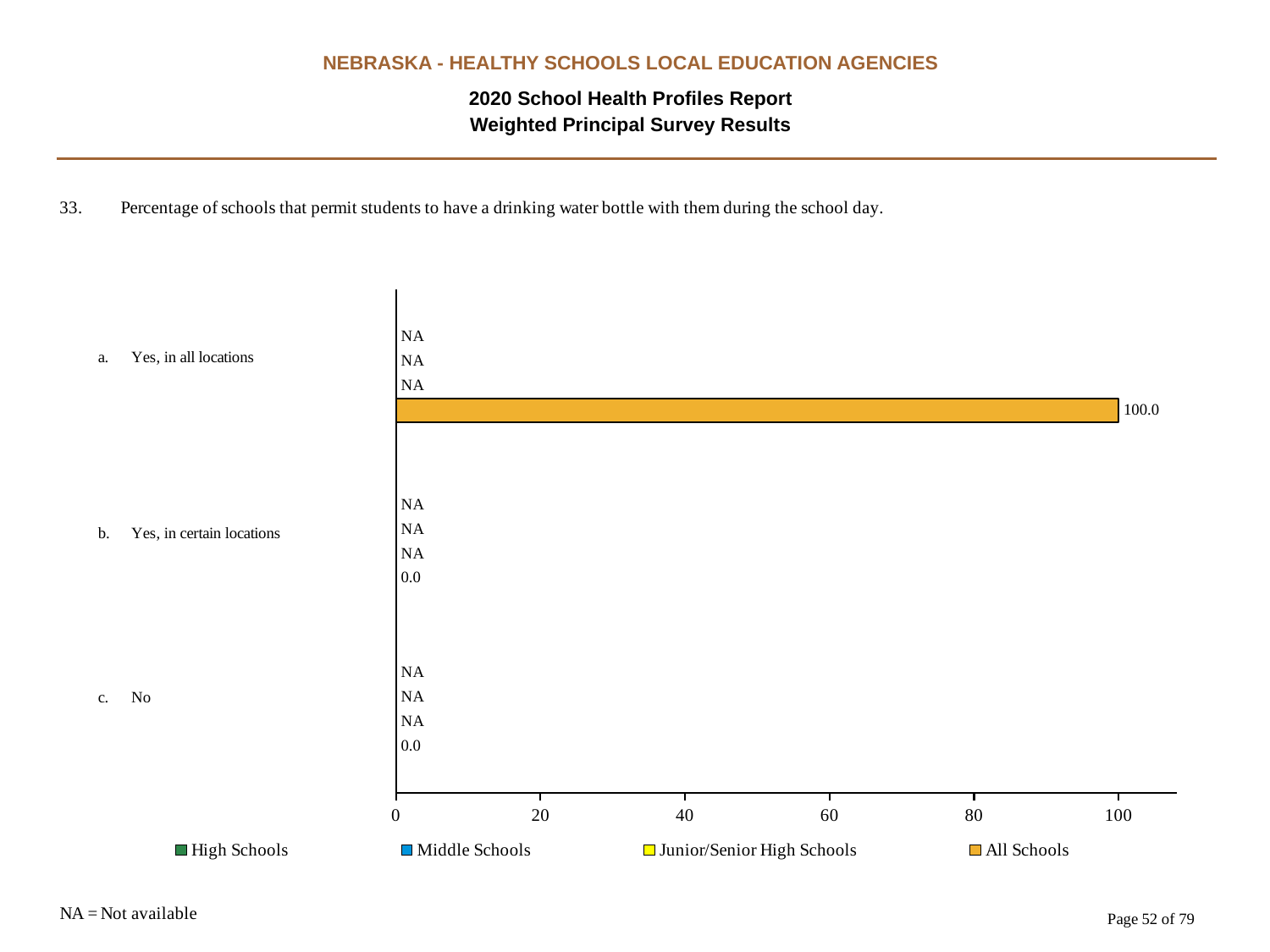
What is shown for High Schools in the 'Yes, in all locations' category? NA Which category has the highest value for All Schools? Yes, in all locations How many categories are shown on the chart? 3 What kind of chart is shown on the slide? Bar chart Which is larger for All Schools: 'Yes, in all locations' or 'Yes, in certain locations'? Yes, in all locations What is the value for All Schools in the 'Yes, in certain locations' category? 0.0 What is the value for All Schools in the 'Yes, in all locations' category? 100.0 What is the value for All Schools in the 'No' category? 0.0 What is the difference between the All Schools values for 'Yes, in all locations' and 'No'? 100.0 What does NA stand for according to the note on the slide? Not available How many series does the legend list? 4 What is shown for Middle Schools in the 'No' category? NA